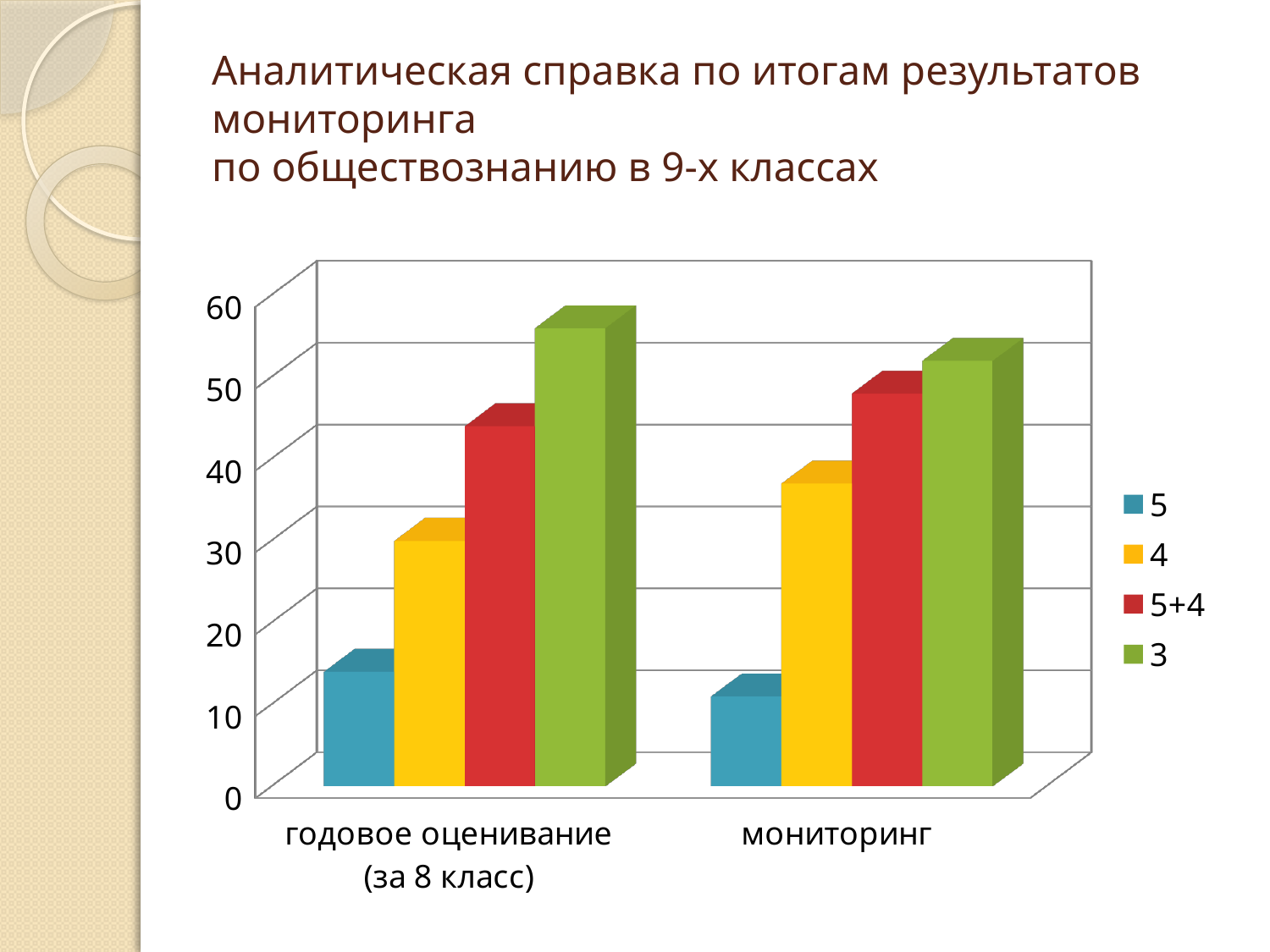
Which series has the lowest value for "мониторинг"? 5 How many categories are shown on the x axis of the chart? 2 Is the value of series "3" for "годовое оценивание (за 8 класс)" greater or less than 50? greater Which series has the highest value for "годовое оценивание (за 8 класс)"? 3 Is the value of series "4" for "мониторинг" greater or less than 30? greater For series "4", which category has the larger value: "годовое оценивание (за 8 класс)" or "мониторинг"? мониторинг Which series has the lowest value for "годовое оценивание (за 8 класс)"? 5 What kind of chart is shown on the slide? bar chart What are the entries listed in the chart legend? 5, 4, 5+4, 3 Which series has the highest value for "мониторинг"? 3 How many series does the chart legend list? 4 Is the value of series "5" for "годовое оценивание (за 8 класс)" greater or less than 20? less